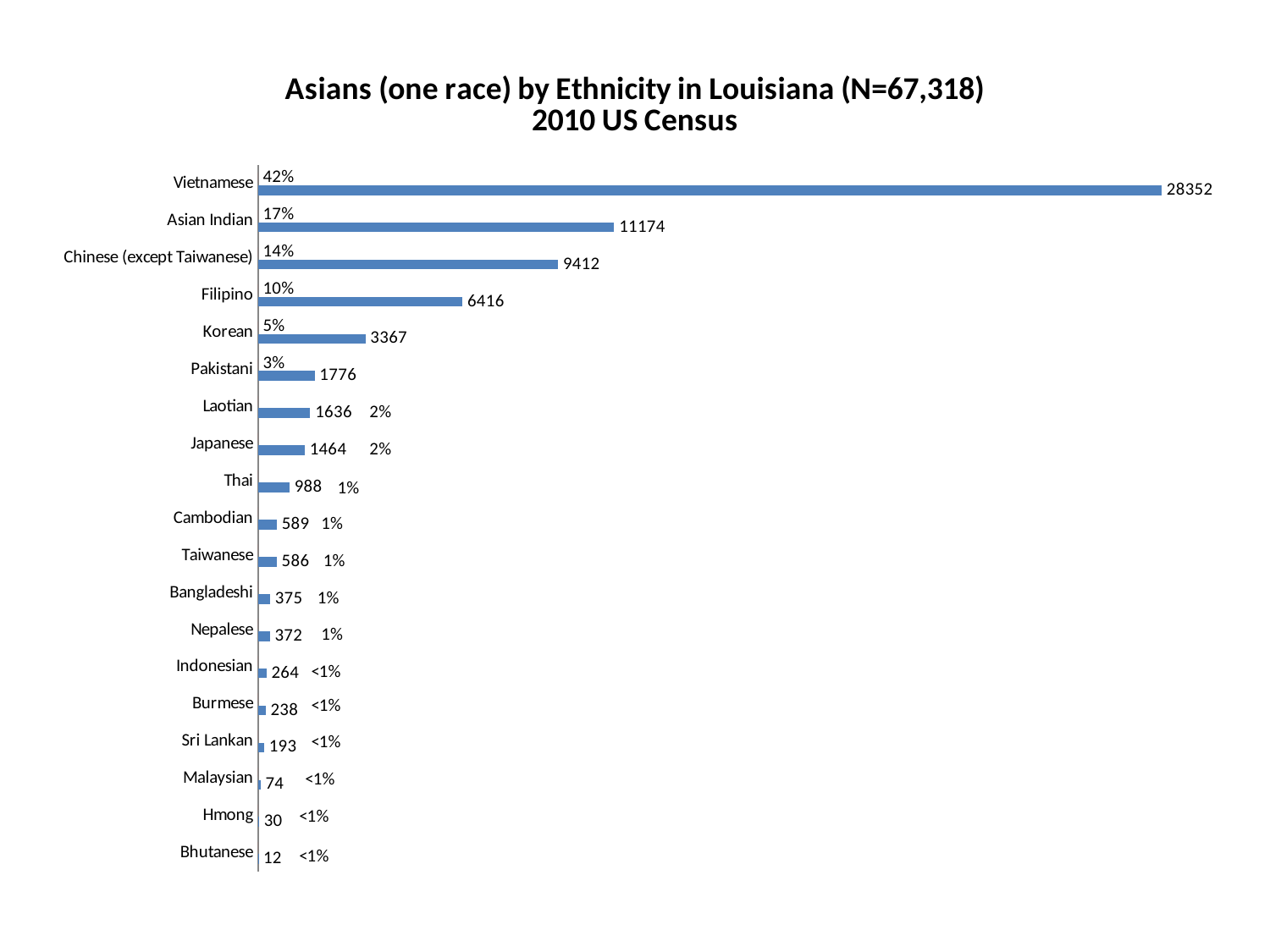
Which is larger, the value for Korean or the value for Pakistani? Korean What is the title of the chart? Asians (one race) by Ethnicity in Louisiana (N=67,318) 2010 US Census What percentage is shown for Asian Indian? 17% What kind of chart is shown on the slide? Bar chart How many ethnicity categories are shown in the chart? 19 What is the difference between the values for Asian Indian and Chinese (except Taiwanese)? 1762 Which ethnicity has the highest value? Vietnamese What is the value for Vietnamese? 28352 What is the value for Laotian? 1636 What is the difference between the values for Thai and Cambodian? 399 What is the value for Filipino? 6416 Which ethnicity has the lowest value? Bhutanese